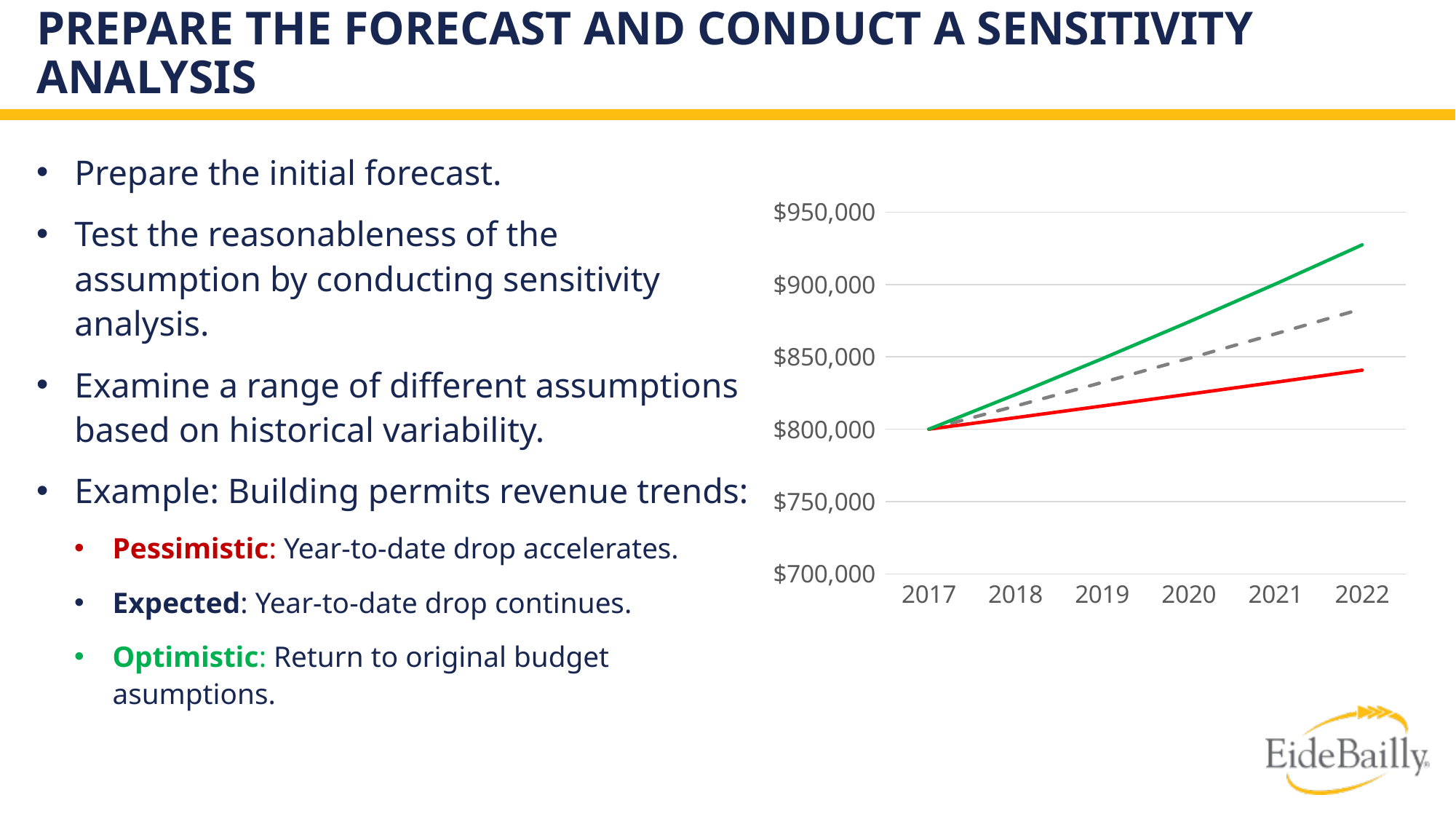
How many years are shown on the x axis of the chart? 6 Which line is highest in 2022: the green, the dashed gray, or the red line? green Which line is lowest in 2022: the green, the dashed gray, or the red line? red What is the highest value labelled on the y axis of the chart? $950,000 Is the value of the dashed gray line in 2022 greater or less than $850,000? greater Does the green line rise or fall from 2017 to 2022? rise What kind of chart is shown on the slide? line chart In 2022, is the green line or the red line higher? green Which of the three lines on the chart is drawn dashed? the gray line At what value do all three lines start in 2017? $800,000 Is the value of the red line in 2022 greater or less than $850,000? less Is the value of the green line in 2022 greater or less than $900,000? greater